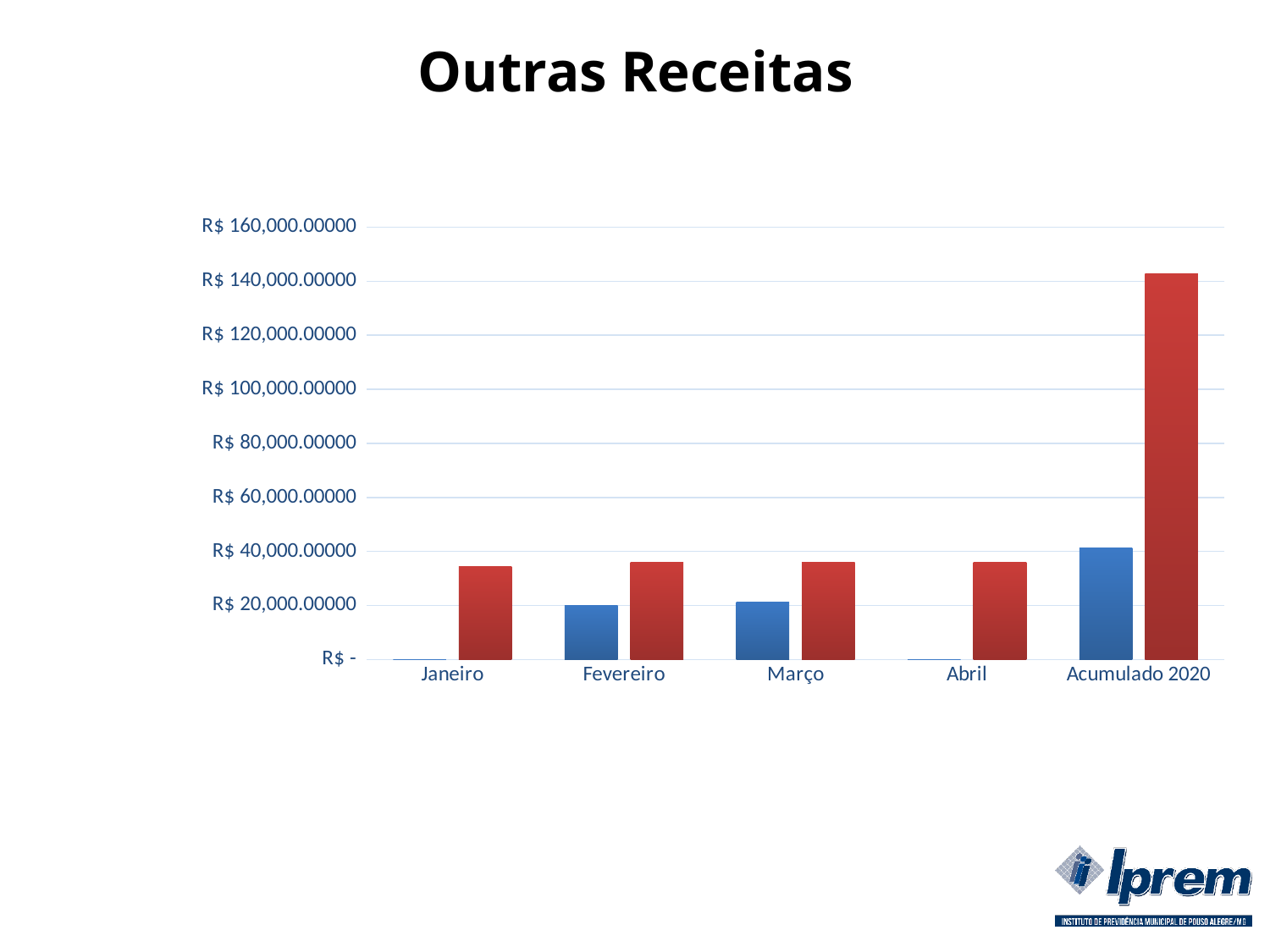
What is the title of the chart on the slide? Outras Receitas How many categories are shown on the x axis of the chart? 5 Is the red bar for Acumulado 2020 greater or less than R$ 120,000? greater Is the blue bar for Março greater or less than R$ 40,000? less Which is taller, the blue bar for Acumulado 2020 or the blue bar for Março? the blue bar for Acumulado 2020 Which category has the tallest red bar? Acumulado 2020 What kind of chart is shown on the slide? bar chart For Fevereiro, which bar is taller, the blue bar or the red bar? the red bar Is the blue bar for Acumulado 2020 greater or less than R$ 60,000? less Which category has the tallest blue bar? Acumulado 2020